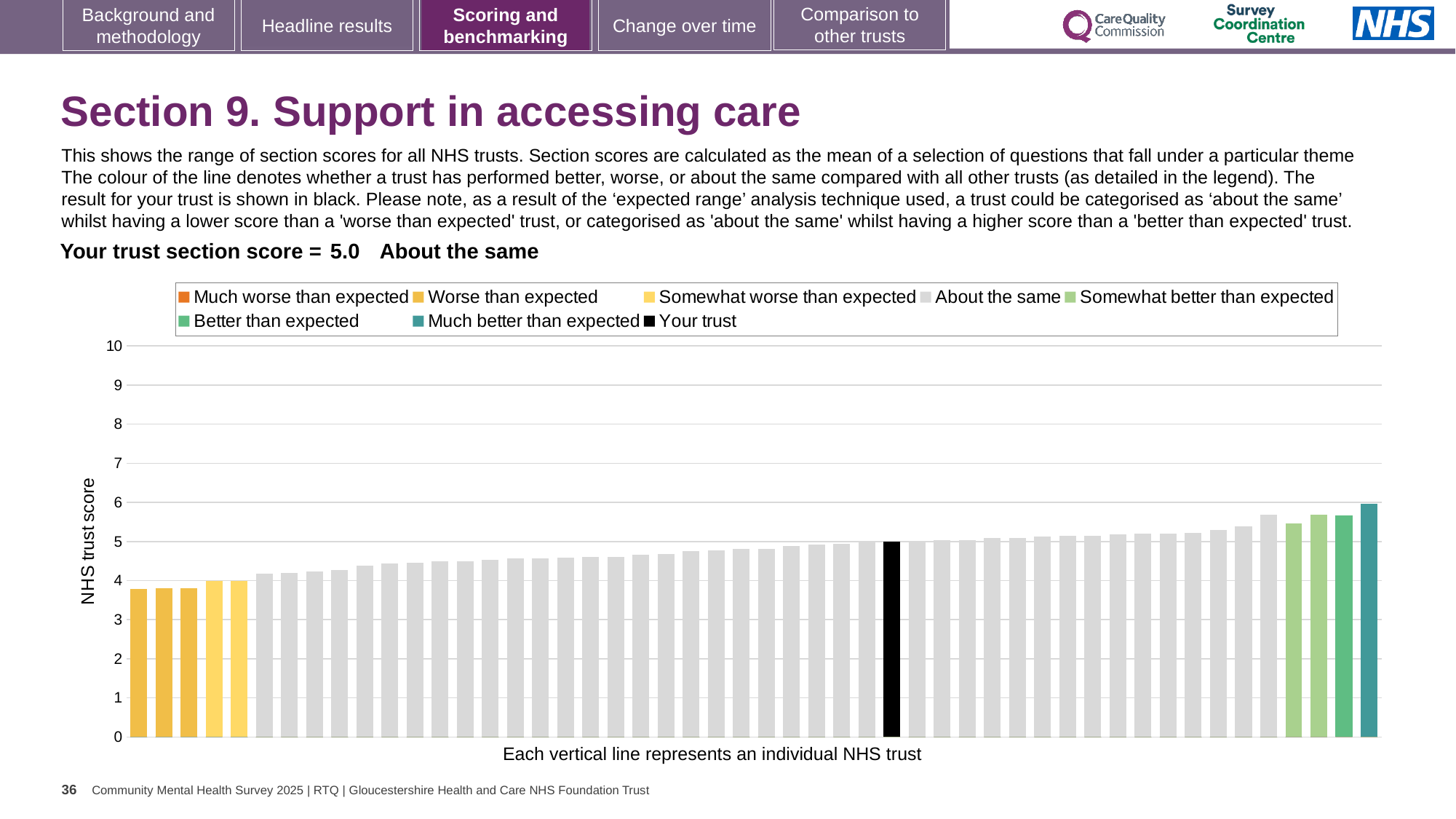
Is the value of the shortest bar in the chart greater or less than 4? less What type of chart is shown on the slide? Bar chart Which legend category do the shortest bars in the chart belong to? Worse than expected What is the section score for your trust shown on the slide? 5.0 Which legend category does the tallest bar in the chart belong to? Much better than expected What is the label on the vertical axis of the chart? NHS trust score Is the value of the black 'Your trust' bar greater or less than 4? greater How many bars are coloured as 'Much better than expected'? 1 How many entries does the chart legend list? 8 Do the bar values rise or fall from left to right across the chart? Rise Which category is your trust placed in for this section? About the same Is the value of the tallest bar in the chart greater or less than 5? greater